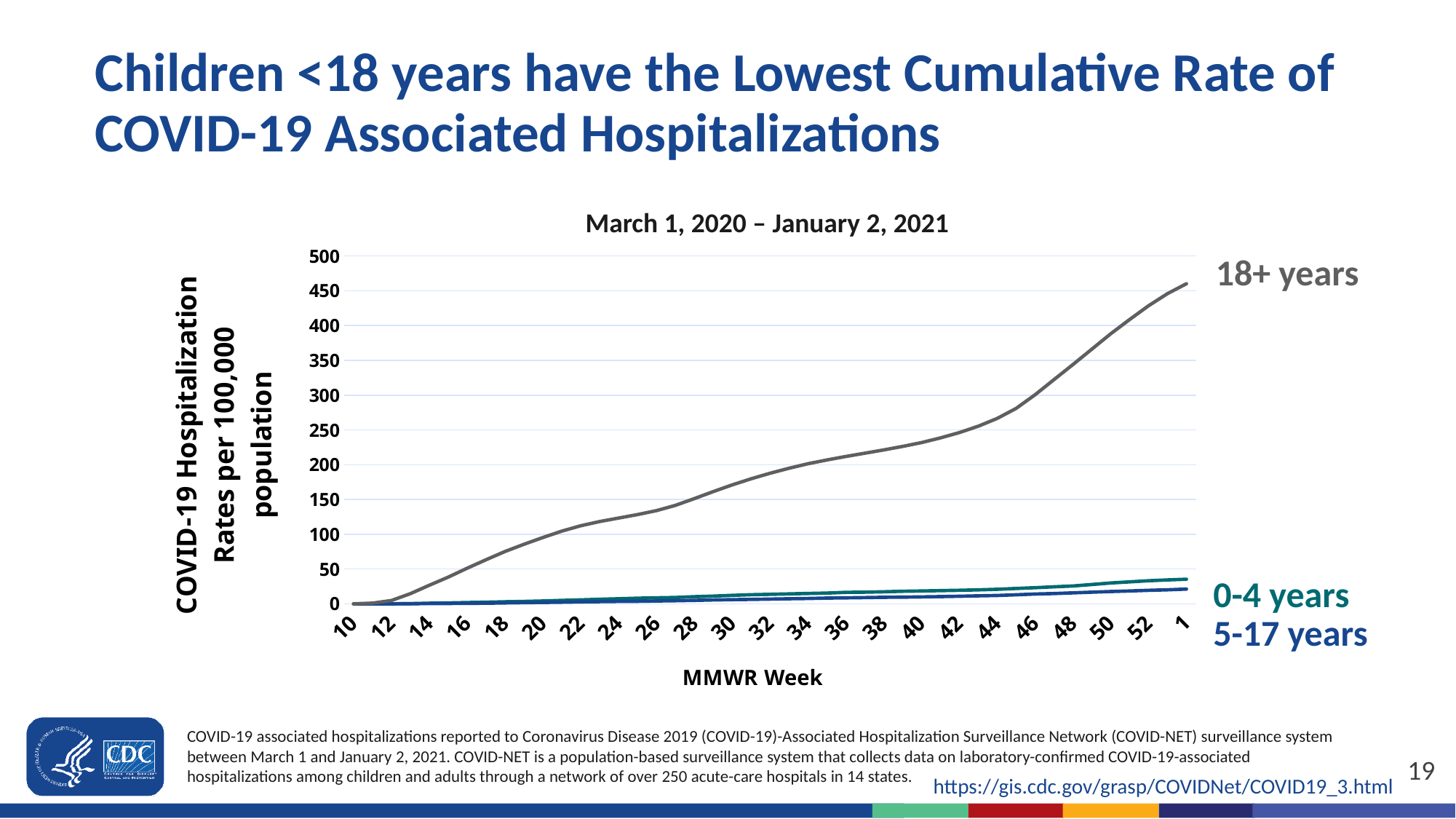
Is the value for 18+ years at MMWR week 14 greater or less than 50? less What date range is given in the chart's subtitle? March 1, 2020 – January 2, 2021 Is the value for 18+ years at MMWR week 40 greater or less than 200? greater What kind of chart is shown on the slide? line chart How many age-group series are plotted on the chart? 3 Which age group has the highest cumulative hospitalization rate at the end of the period (week 1)? 18+ years Is the value for 18+ years at MMWR week 1 greater or less than 400? greater What is the label of the x axis? MMWR Week Which age group has the lowest cumulative hospitalization rate at the end of the period (week 1)? 5-17 years Do the cumulative hospitalization rates rise or fall along the x axis? rise At MMWR week 1, which is larger: the rate for 0-4 years or the rate for 5-17 years? 0-4 years